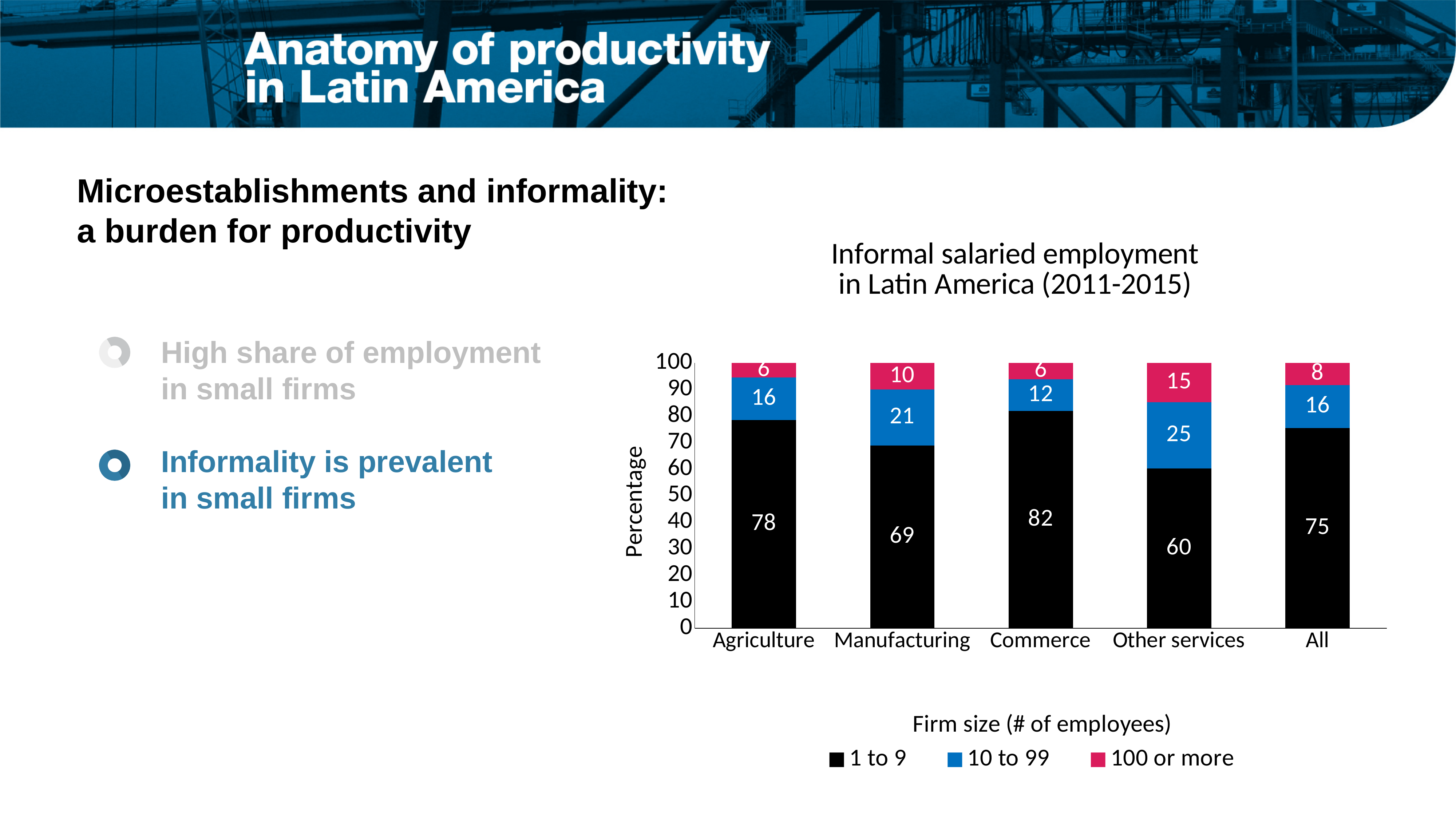
What is the value for the 100 or more firm size in Manufacturing? 10 How many sector categories are shown on the x axis? 5 What is the total of the stacked bar for Agriculture? 100 Which sector has the highest value for the 1 to 9 firm size? Commerce What is the difference between the 1 to 9 values for Agriculture and Manufacturing? 9 What is the title of the chart? Informal salaried employment in Latin America (2011-2015) What type of chart is shown on the slide? Stacked bar chart What is the value for the 10 to 99 firm size in Other services? 25 What is the value for the 1 to 9 firm size in Commerce? 82 Which sector has the lowest value for the 1 to 9 firm size? Other services How many firm size series does the legend list? 3 Which is larger: the 10 to 99 value for Manufacturing or for Commerce? Manufacturing